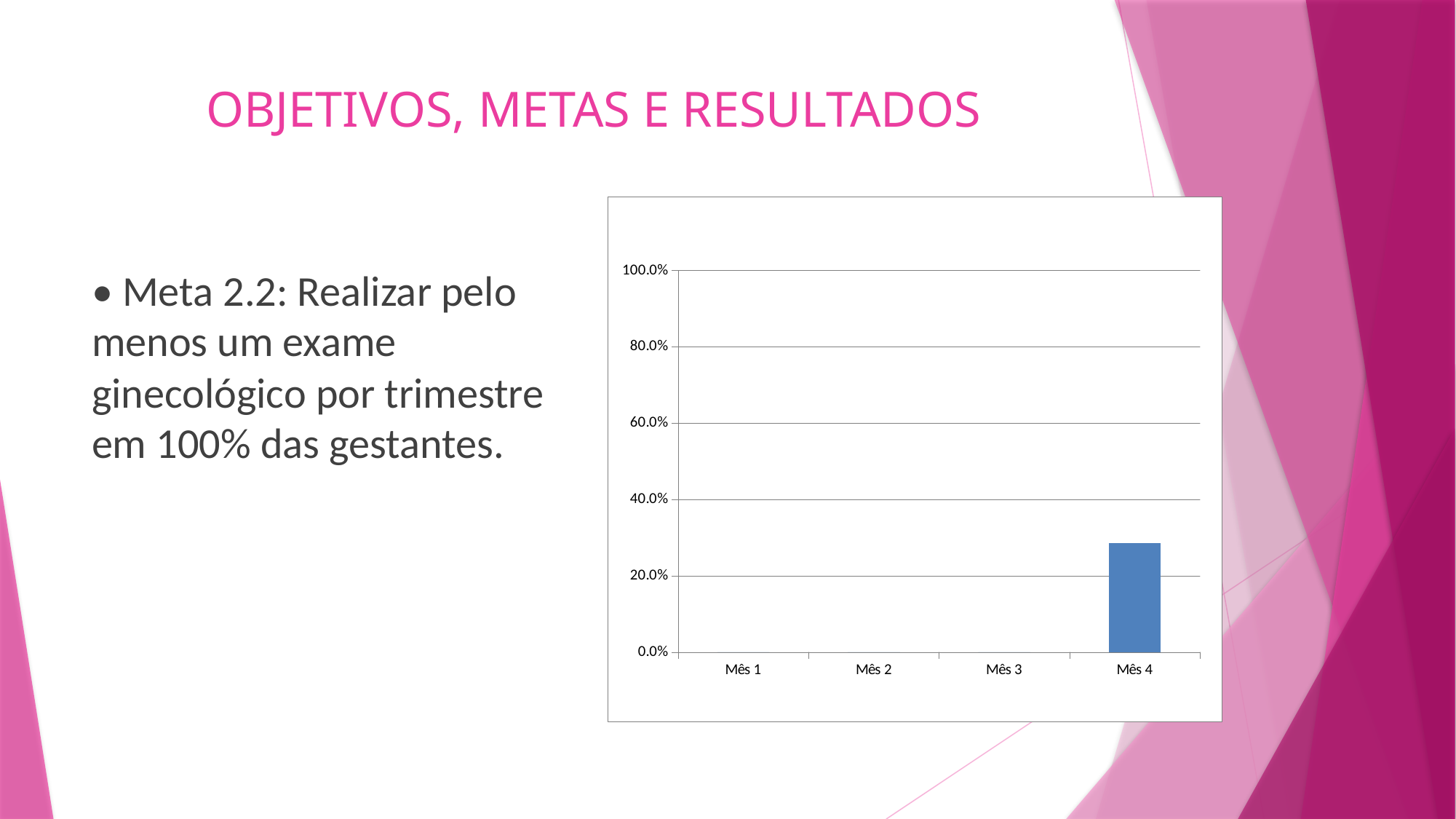
Which is larger, the value for Mês 3 or the value for Mês 4? Mês 4 Is the value for Mês 4 greater or less than 60.0%? less How many categories are shown on the x axis of the chart? 4 What is the highest value labelled on the vertical axis of the chart? 100.0% What is the label of the last category on the x axis? Mês 4 Which is larger, the value for Mês 1 or the value for Mês 4? Mês 4 Do the values rise or fall from Mês 1 to Mês 4? rise Is the value for Mês 4 greater or less than 20.0%? greater What kind of chart is shown on the slide? bar chart Which month has the highest value in the chart? Mês 4 Is the value for Mês 4 greater or less than 40.0%? less